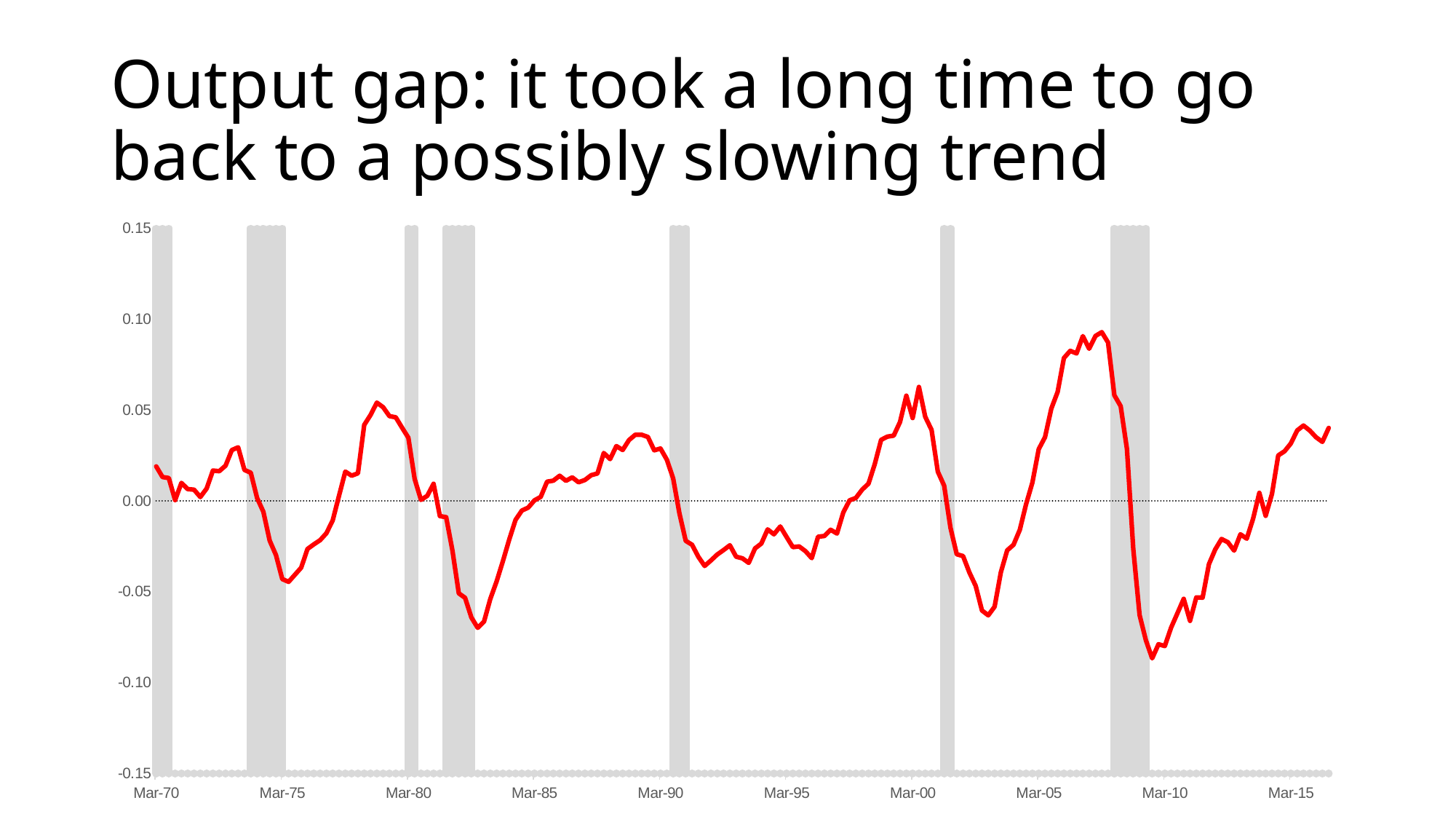
What is the highest value shown on the y axis? 0.15 Which is larger, the value at Mar-10 or the value at Mar-15? Mar-15 Which is larger, the value at Mar-90 or the value at Mar-95? Mar-90 Is the value at Mar-90 greater or less than 0.00? greater What kind of chart is shown on the slide? line chart How many labelled tick marks are on the x axis? 10 Does the line rise or fall between Mar-10 and Mar-15? rise Is the value at Mar-05 greater or less than 0.00? greater How many grey shaded bands are drawn on the chart? 7 Is the value at Mar-10 greater or less than -0.05? less What is the title of the slide? Output gap: it took a long time to go back to a possibly slowing trend